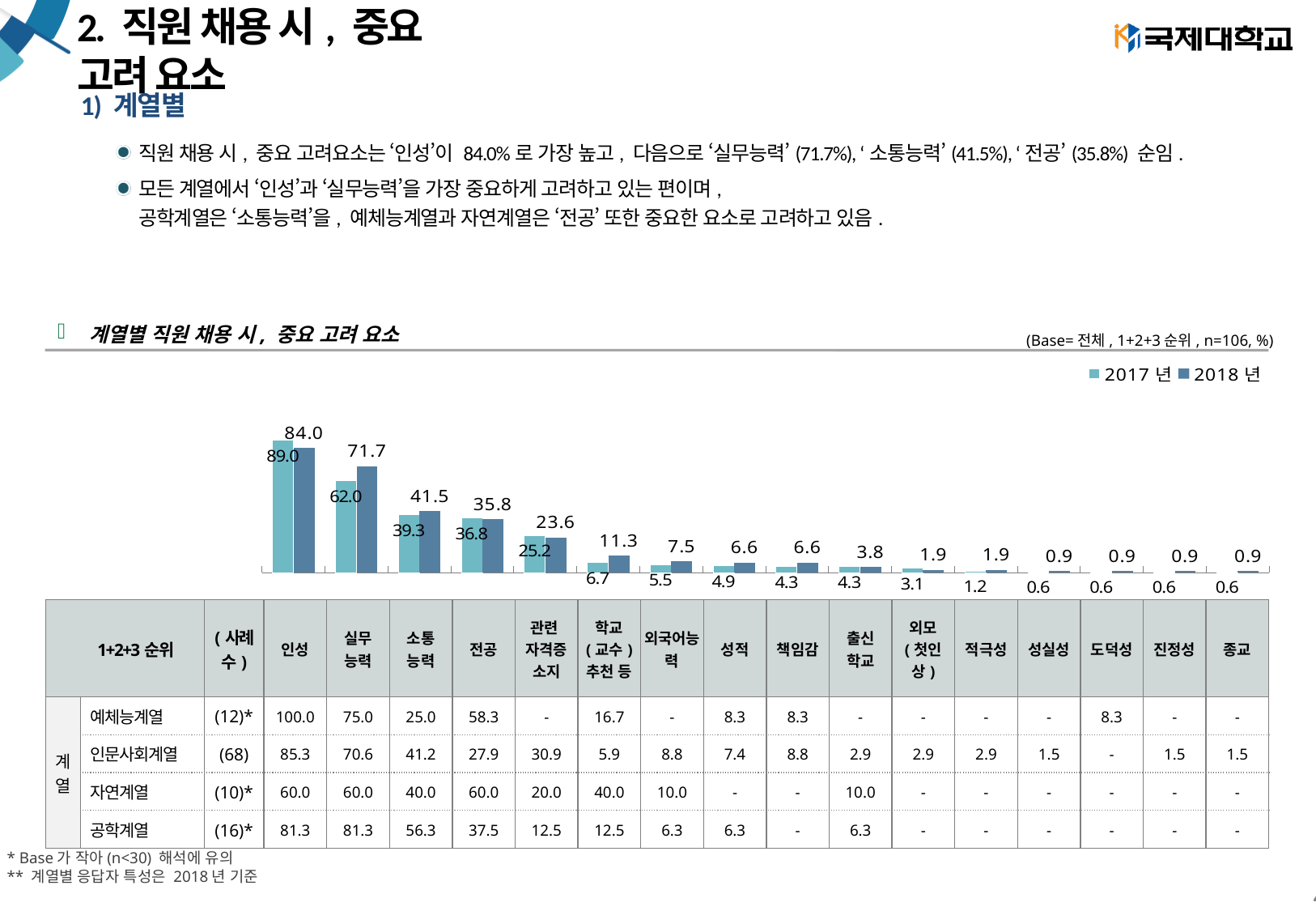
What is the 2018년 value for 학교(교수) 추천 등? 11.3 How many series does the chart legend list? 2 What type of chart is shown on the slide? bar chart What is the 2017년 value for 관련 자격증 소지? 25.2 What is the 2017년 value for 실무능력? 62.0 Which category has the highest 2018년 value? 인성 What is the difference between the 2017년 and 2018년 values for 실무능력? 9.7 What is the 2018년 value for 인성? 84.0 What is the difference between the 2018년 values for 인성 and 실무능력? 12.3 What are the two series named in the chart legend? 2017년, 2018년 What is the 2018년 value for 소통능력? 41.5 Which is larger for 전공: the 2017년 value or the 2018년 value? 2017년